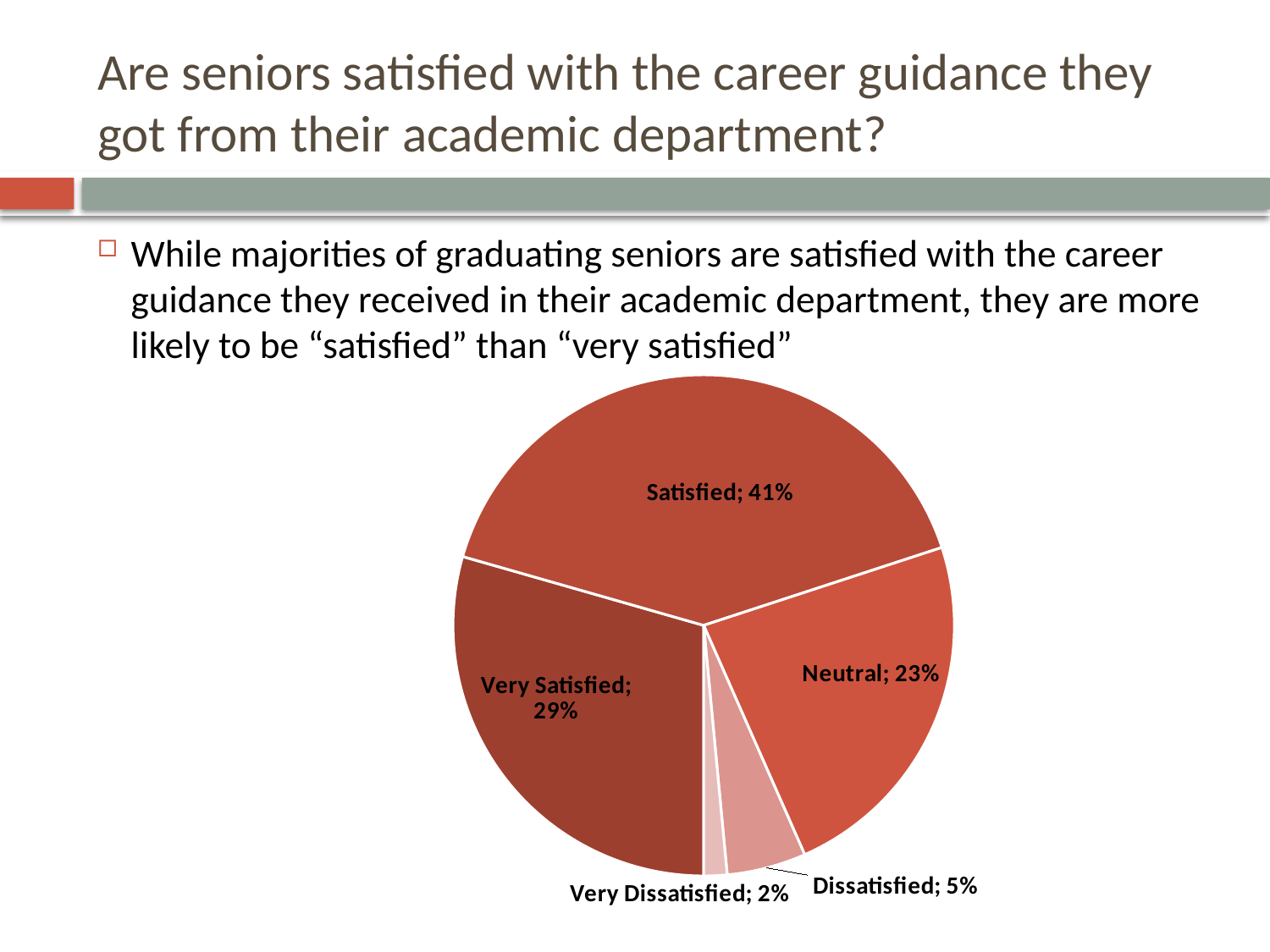
Which is larger, the Neutral share or the Very Satisfied share? Very Satisfied Which category has the smallest share of the pie? Very Dissatisfied What is the difference in percentage points between Satisfied and Very Satisfied? 12 Which category has the largest share of the pie? Satisfied How many categories are shown in the pie chart? 5 What kind of chart is shown on the slide? Pie chart What percentage of seniors are Satisfied with the career guidance from their academic department? 41% What percentage of seniors are Very Dissatisfied? 2% What percentage of seniors are Very Satisfied? 29% What percentage of seniors are Dissatisfied? 5% What percentage of seniors are Neutral? 23% What is the combined percentage of Satisfied and Very Satisfied seniors? 70%